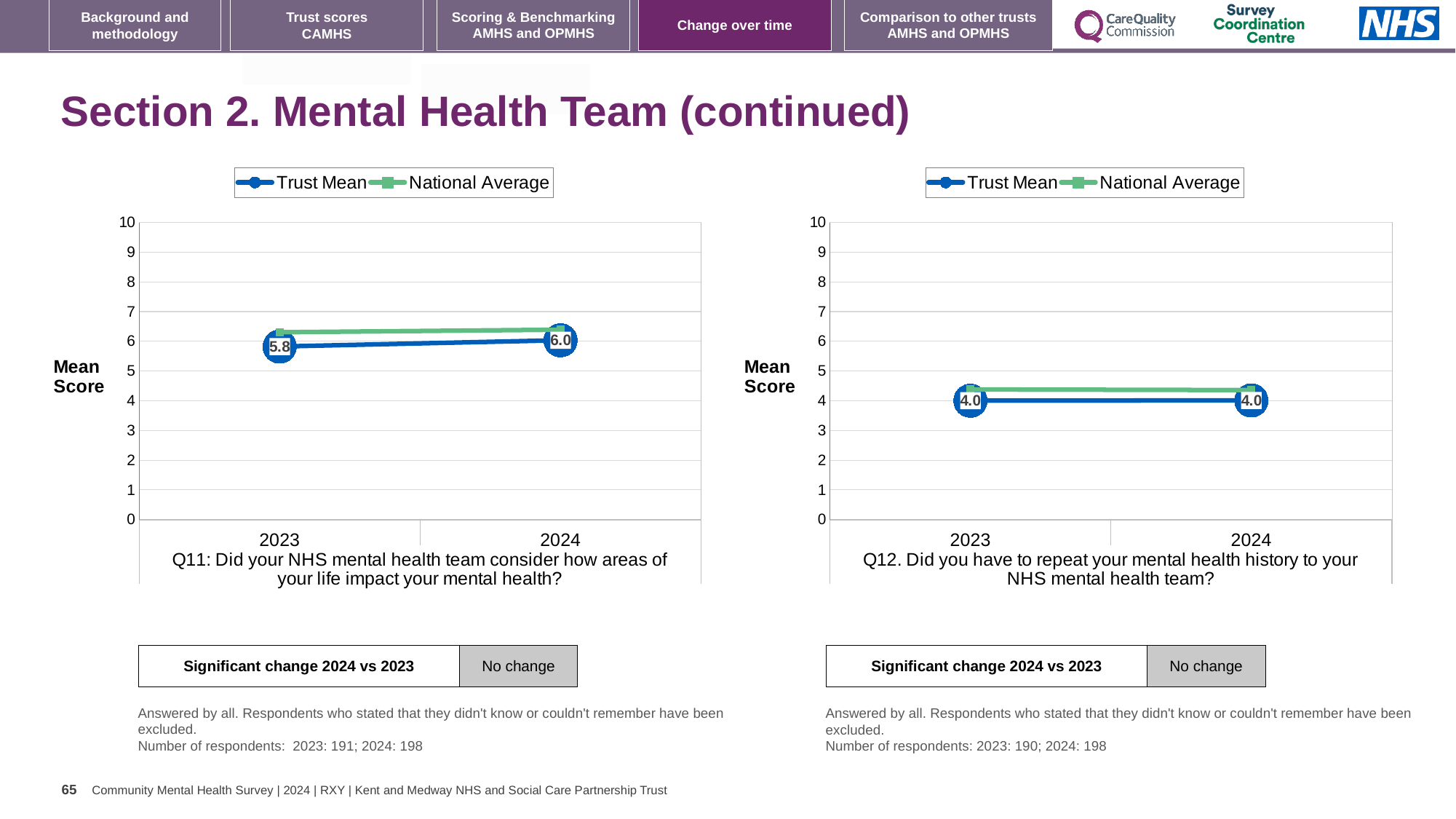
How many series does the legend of the right chart (Q12) list? 2 How many years are plotted on the x axis of the left chart (Q11)? 2 In the left chart (Q11), what is the Trust Mean score for 2023? 5.8 In the left chart (Q11), is the National Average for 2023 greater or less than 6? greater In the right chart (Q12), what is the Trust Mean score for 2024? 4.0 In the left chart (Q11), what is the Trust Mean score for 2024? 6.0 In the left chart (Q11), which is larger for 2023, the Trust Mean or the National Average? National Average In the left chart (Q11), does the Trust Mean rise or fall from 2023 to 2024? rise What kind of chart is the left chart (Q11)? line chart In the right chart (Q12), does the Trust Mean rise, fall or stay the same from 2023 to 2024? stay the same What is the y-axis label on the right chart (Q12)? Mean Score In the left chart (Q11), by how much did the Trust Mean change from 2023 to 2024? 0.2